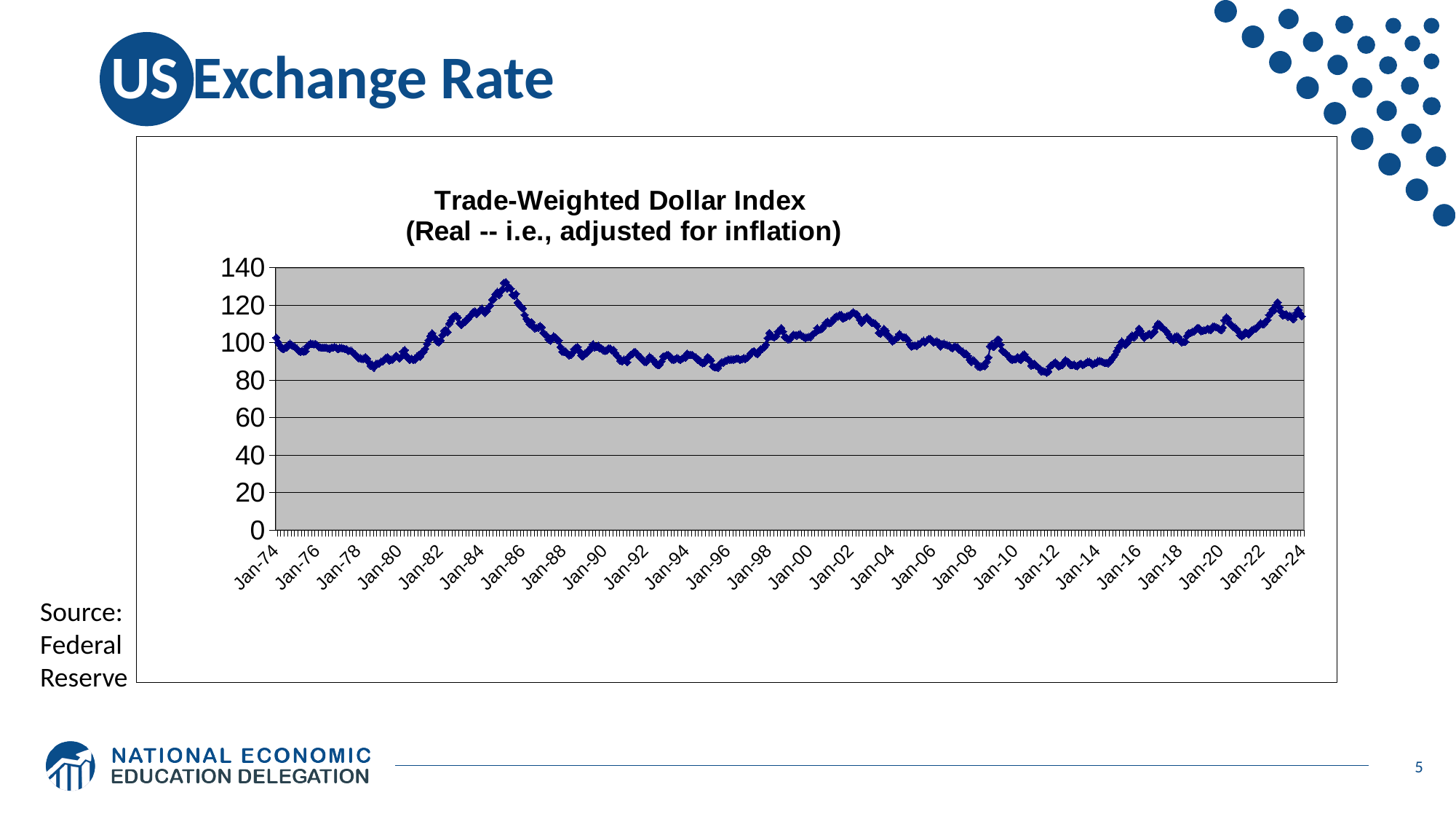
What is the highest value shown on the vertical axis of the chart? 140 What is the title of the chart? Trade-Weighted Dollar Index (Real -- i.e., adjusted for inflation) Is the peak value of the index around 1985 greater or less than 120? greater Does the index rise or fall between Jan-86 and Jan-88? fall Does the index rise or fall between Jan-80 and Jan-84? rise Is the value of the index at Jan-24 greater or less than 100? greater Which is larger, the index value at Jan-86 or at Jan-92? Jan-86 Is the value of the index at Jan-78 greater or less than 100? less What kind of chart is shown on the slide? line chart